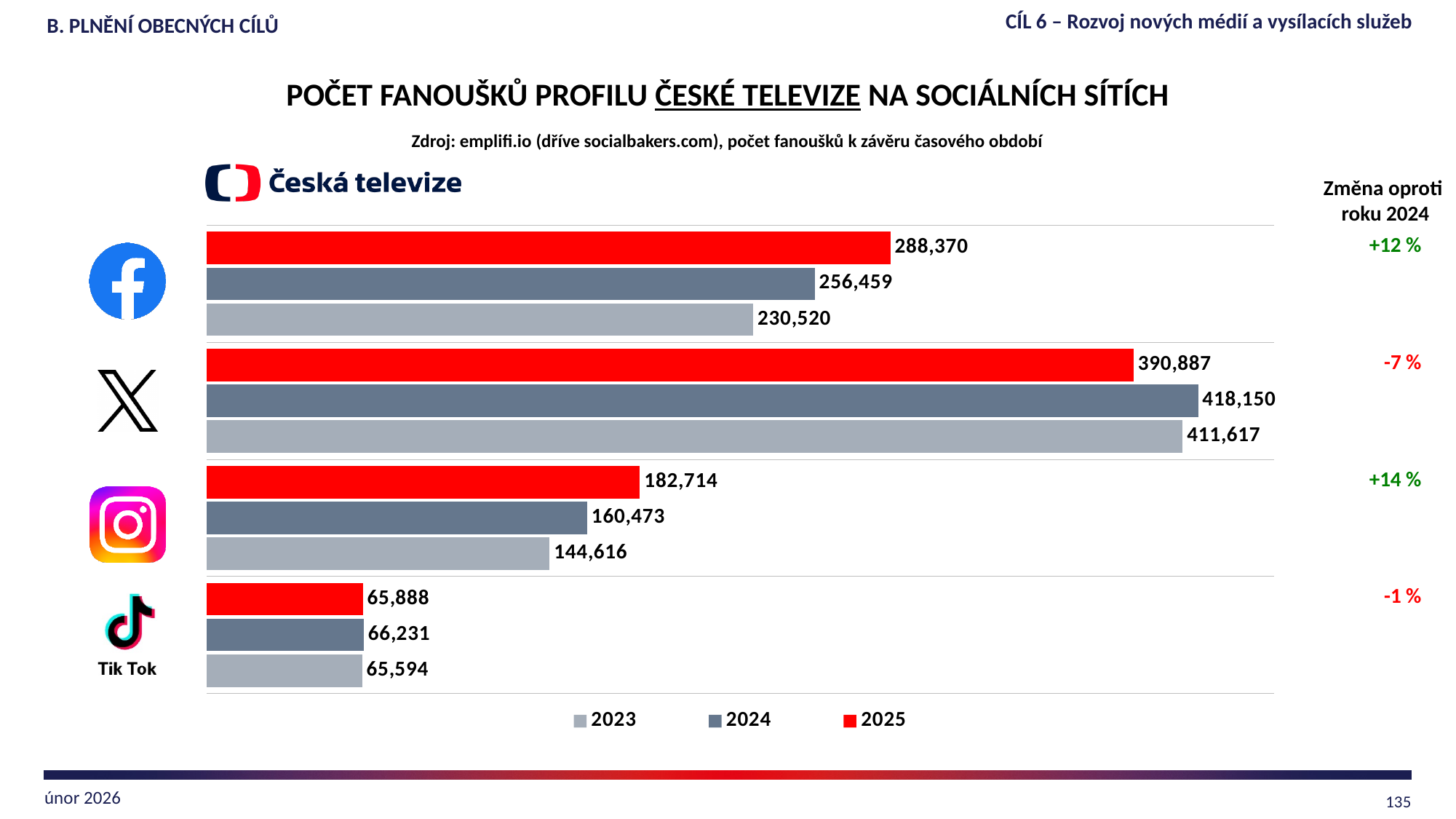
How many series (years) does the legend list? 3 How many fans did the Česká televize Facebook profile have in 2025? 288,370 By how much did the number of fans on X decrease from 2024 to 2025? 27,263 What was the number of fans on X (Twitter) in 2024? 418,150 What was the number of Instagram fans in 2023? 144,616 What percentage change compared to 2024 is shown for Instagram? +14 % What was the number of TikTok fans in 2025? 65,888 Which social network had the lowest number of fans in 2025? Tik Tok Which is larger: the number of Instagram fans in 2025 or the number of Facebook fans in 2023? Facebook fans in 2023 Which social network had the highest number of fans in 2025? X By how much did the number of Facebook fans increase from 2024 to 2025? 31,911 How many social networks are shown in the chart? 4